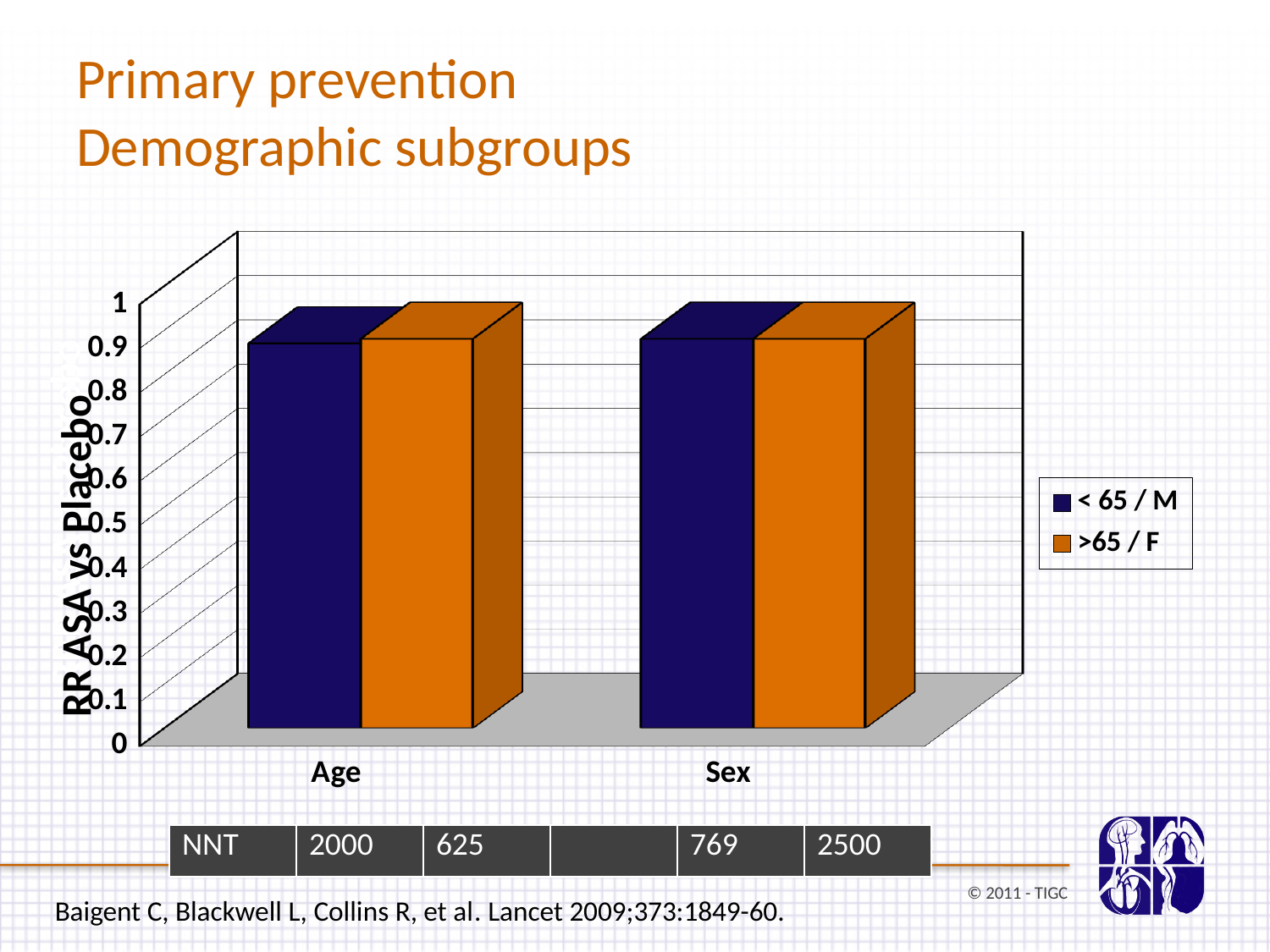
What kind of chart is shown on the slide? bar chart What are the two entries in the chart legend? < 65 / M and >65 / F Is the value for the >65 / F series in the Age category greater or less than 1? less Is the value for the < 65 / M series in the Age category greater or less than 0.5? greater Is the value for the >65 / F series in the Sex category greater or less than 0.5? greater How many series does the chart legend list? 2 What is the title of the vertical axis of the chart? RR ASA vs Placebo How many categories are shown on the x axis of the chart? 2